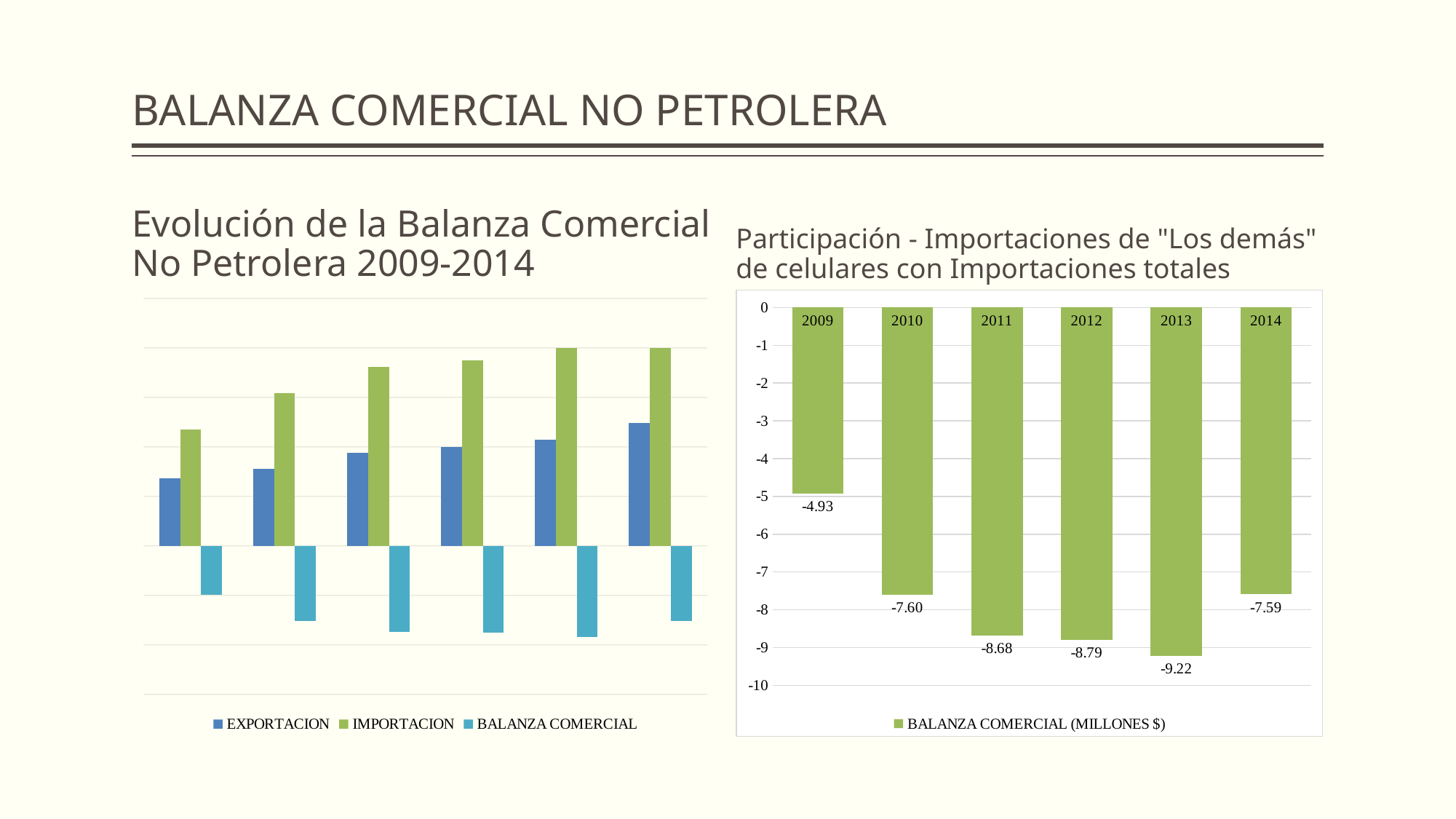
In the right-hand chart, what is the value for 2014? -7.59 What kind of chart is the left-hand chart "Evolución de la Balanza Comercial No Petrolera 2009-2014"? Bar chart In the right-hand chart, which year has the highest value? 2009 In the right-hand chart, how many years are plotted? 6 In the chart titled "Evolución de la Balanza Comercial No Petrolera 2009-2014", how many series does the legend list? 3 In the right-hand chart, which year has the larger value, 2010 or 2012? 2010 In the chart titled "Participación - Importaciones de "Los demás" de celulares con Importaciones totales", what is the value for 2011? -8.68 In the left-hand chart, do the IMPORTACION values rise or fall from left to right? Rise In the right-hand chart, what is the difference between the values for 2009 and 2013? 4.29 In the right-hand chart, which year has the lowest (most negative) value? 2013 In the right-hand chart, what is the series name shown in the legend? BALANZA COMERCIAL (MILLONES $) In the left-hand chart, which series has the larger value in the first group, EXPORTACION or IMPORTACION? IMPORTACION